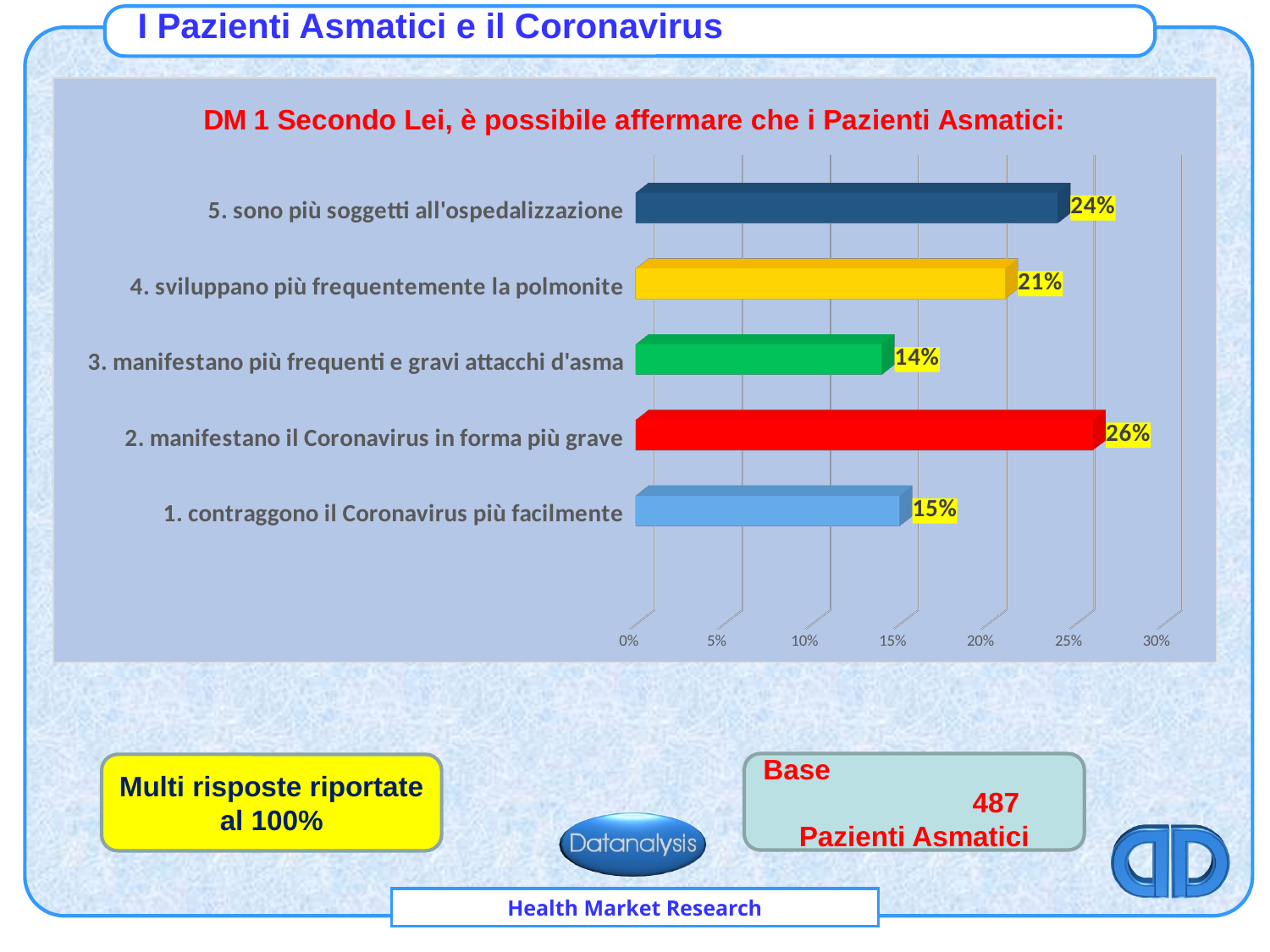
What colour is the bar for "3. manifestano più frequenti e gravi attacchi d'asma"? green What is the value for "5. sono più soggetti all'ospedalizzazione"? 24% Which is larger: the value for "5. sono più soggetti all'ospedalizzazione" or for "4. sviluppano più frequentemente la polmonite"? 5. sono più soggetti all'ospedalizzazione What is the difference between the values for "2. manifestano il Coronavirus in forma più grave" and "4. sviluppano più frequentemente la polmonite"? 5% Is the value for "3. manifestano più frequenti e gravi attacchi d'asma" greater or less than 20%? less Which category has the highest value? 2. manifestano il Coronavirus in forma più grave What is the title of the chart? DM 1 Secondo Lei, è possibile affermare che i Pazienti Asmatici: What kind of chart is shown on the slide? bar chart Which category has the lowest value? 3. manifestano più frequenti e gravi attacchi d'asma What is the value for "1. contraggono il Coronavirus più facilmente"? 15% How many categories are shown in the chart? 5 What is the value for "2. manifestano il Coronavirus in forma più grave"? 26%